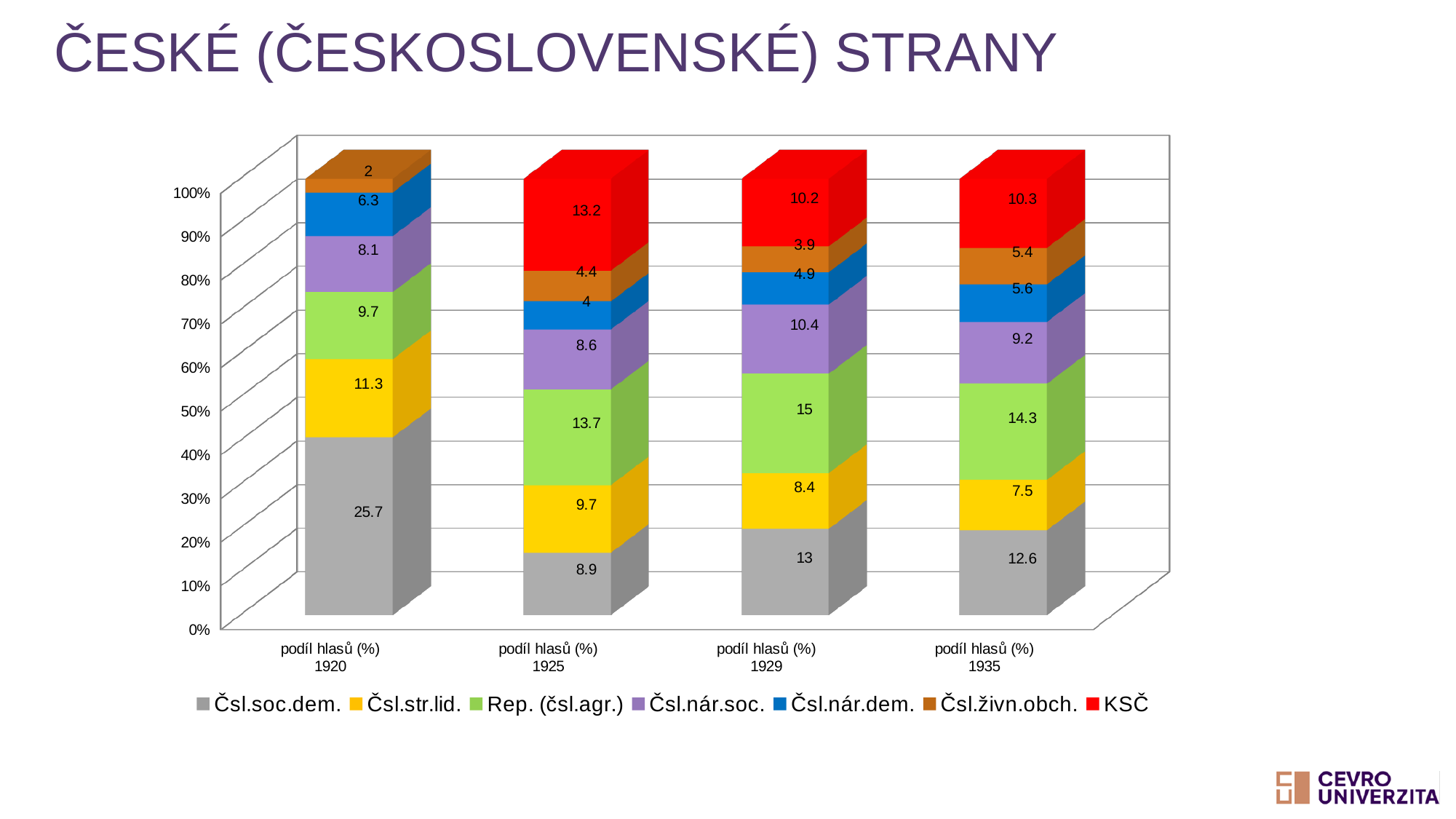
Does the value for Čsl.str.lid. rise or fall from 1920 to 1935? Fall Which party has the smallest segment in the 1920 bar? Čsl.živn.obch. What is the difference between the values for Čsl.soc.dem. and Čsl.str.lid. in 1920? 14.4 What is the value for Čsl.soc.dem. in 1920? 25.7 How many parties does the legend list? 7 How many election years (bars) are shown on the x axis? 4 Which party has the largest segment in the 1920 bar? Čsl.soc.dem. What is the value for KSČ in 1925? 13.2 What is the value for Rep. (čsl.agr.) in 1929? 15 In 1929, which is larger: the value for Rep. (čsl.agr.) or the value for Čsl.soc.dem.? Rep. (čsl.agr.) What is the value for Čsl.nár.dem. in 1935? 5.6 What kind of chart is shown on the slide? Stacked bar chart